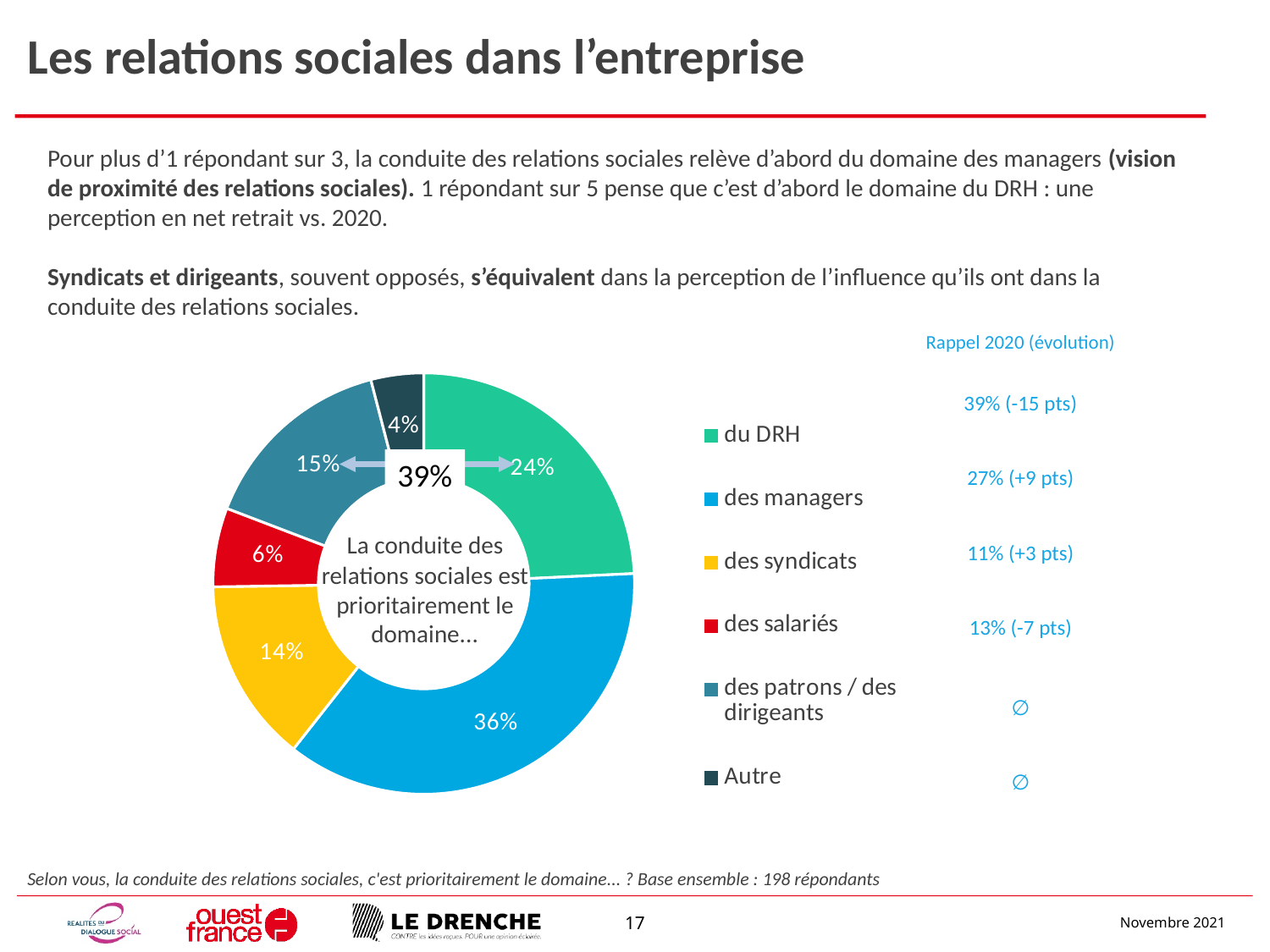
What percentage is shown for 'du DRH'? 24% What percentage is shown for 'des patrons / des dirigeants'? 15% What percentage is shown for 'Autre'? 4% Which is larger, the share for 'des syndicats' or the share for 'des salariés'? des syndicats What percentage is shown for 'des syndicats'? 14% Which category has the largest share of the doughnut chart? des managers What is the difference in percentage points between 'des managers' and 'du DRH'? 12 What kind of chart is shown on the slide? Doughnut chart What percentage of respondents say social relations are primarily the domain of 'des managers'? 36% How many categories does the legend of the doughnut chart list? 6 Which category has the smallest share of the doughnut chart? Autre What value is printed in the centre of the doughnut chart? 39%